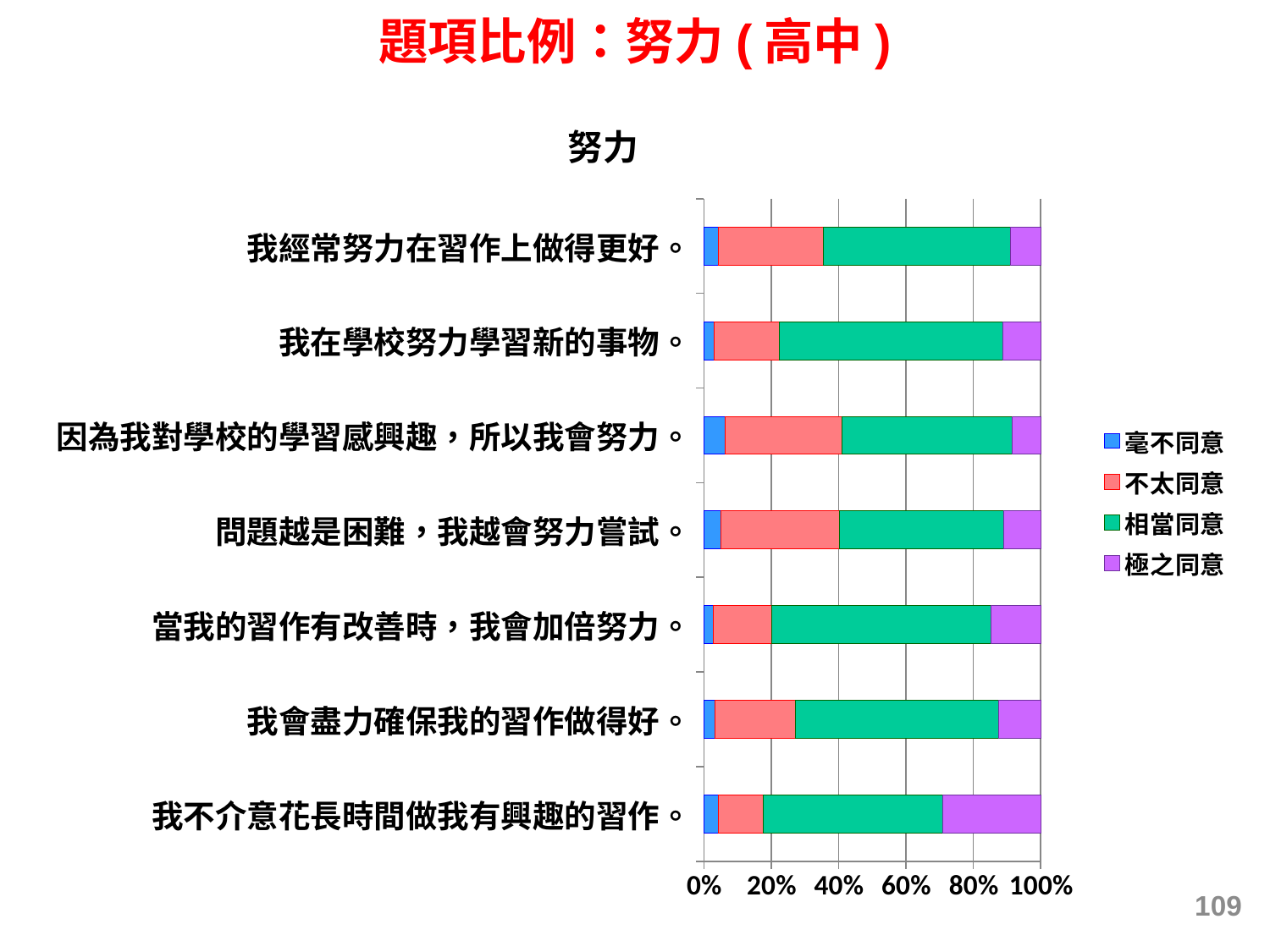
How many statements (categories) are plotted in the chart? 7 Which has the larger 極之同意 segment: 我不介意花長時間做我有興趣的習作。 or 我經常努力在習作上做得更好。? 我不介意花長時間做我有興趣的習作。 Is the 不太同意 share for 因為我對學校的學習感興趣，所以我會努力。 greater or less than 20%? greater What kind of chart is shown on the slide? Stacked bar chart Which legend entry is shown in purple? 極之同意 Which statement has the largest 極之同意 segment? 我不介意花長時間做我有興趣的習作。 How many series does the legend list? 4 Is the 相當同意 share for 我不介意花長時間做我有興趣的習作。 greater or less than 60%? less Which statement has the smallest 相當同意 segment? 問題越是困難，我越會努力嘗試。 Which has the larger 不太同意 segment: 因為我對學校的學習感興趣，所以我會努力。 or 我在學校努力學習新的事物。? 因為我對學校的學習感興趣，所以我會努力。 Is the 極之同意 share for 我不介意花長時間做我有興趣的習作。 greater or less than 20%? greater What is the title shown above the chart? 努力